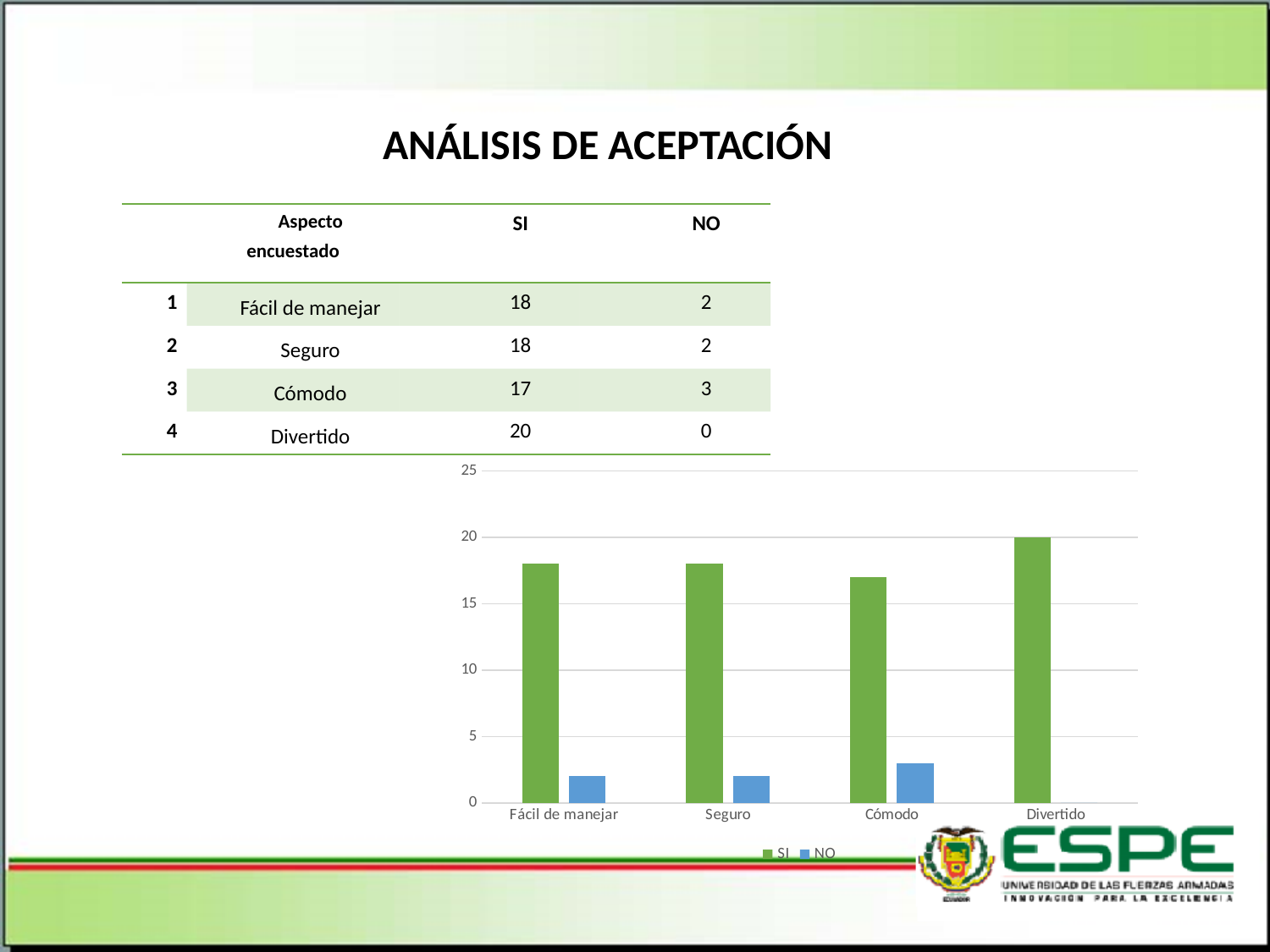
What is the SI value for Fácil de manejar? 18 Is the SI value for Cómodo greater or less than 15? greater What is the difference between the SI and NO values for Seguro? 16 How many series does the chart legend list? 2 Which colour represents the SI series in the chart? Green Which category has the lowest SI value? Cómodo How many categories are shown on the x axis of the chart? 4 Which category has the highest SI value? Divertido What is the SI value for Divertido? 20 Which is larger, the NO value for Cómodo or the NO value for Seguro? Cómodo What kind of chart is shown on the slide? Bar chart What is the NO value for Cómodo? 3